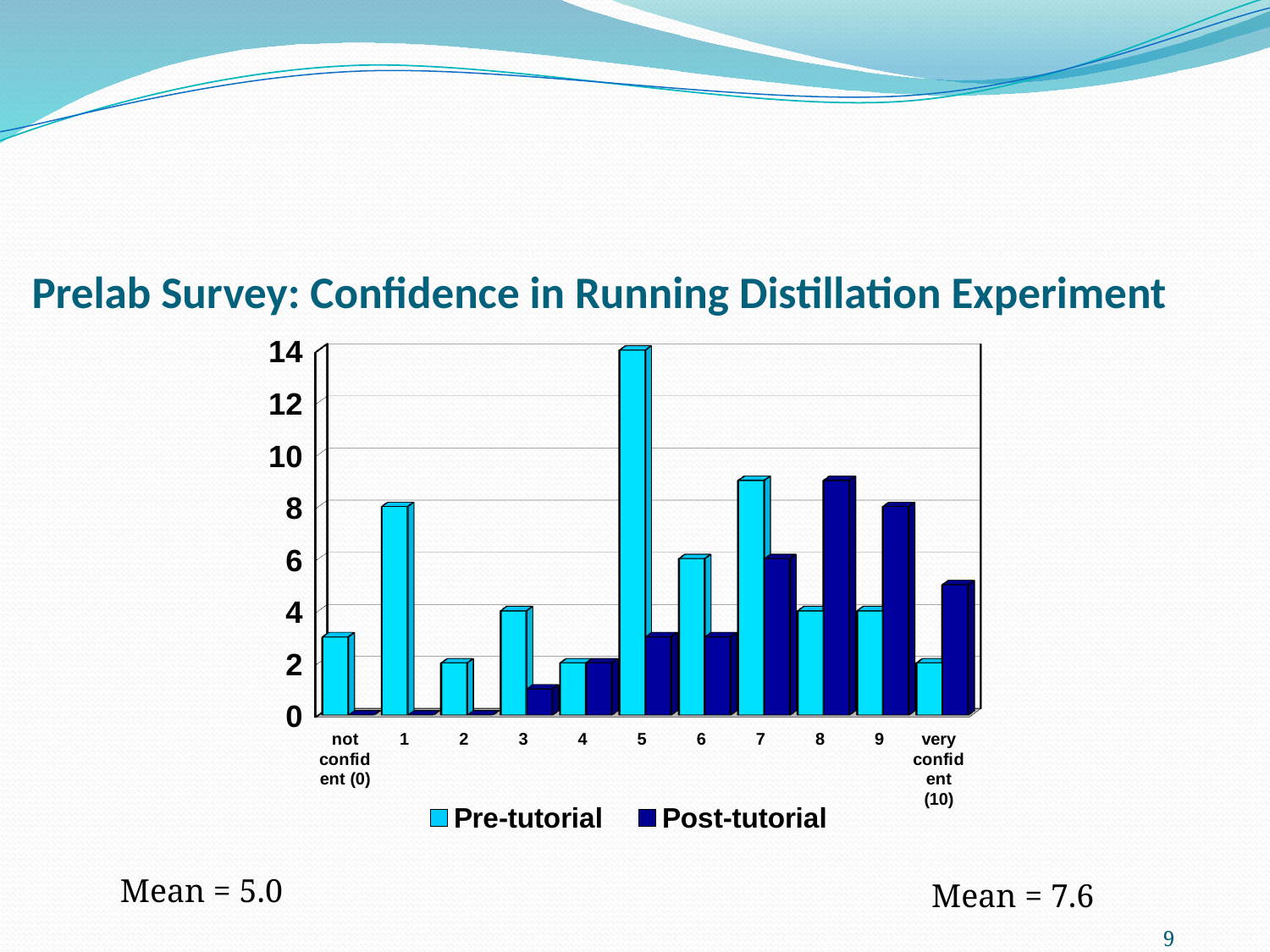
At confidence level 8, which series has the larger value, Pre-tutorial or Post-tutorial? Post-tutorial How many confidence categories are shown along the x axis? 11 What kind of chart is shown on the slide? bar chart Is the Post-tutorial value for confidence level 8 greater or less than 8? greater How many series does the legend list? 2 Is the Pre-tutorial value for confidence level 5 greater or less than 12? greater What is the title of the chart? Prelab Survey: Confidence in Running Distillation Experiment At confidence level 5, which series has the larger value, Pre-tutorial or Post-tutorial? Pre-tutorial Is the Pre-tutorial value for confidence level 1 greater or less than 6? greater Which confidence level has the highest Post-tutorial bar? 8 Which confidence level has the highest Pre-tutorial bar? 5